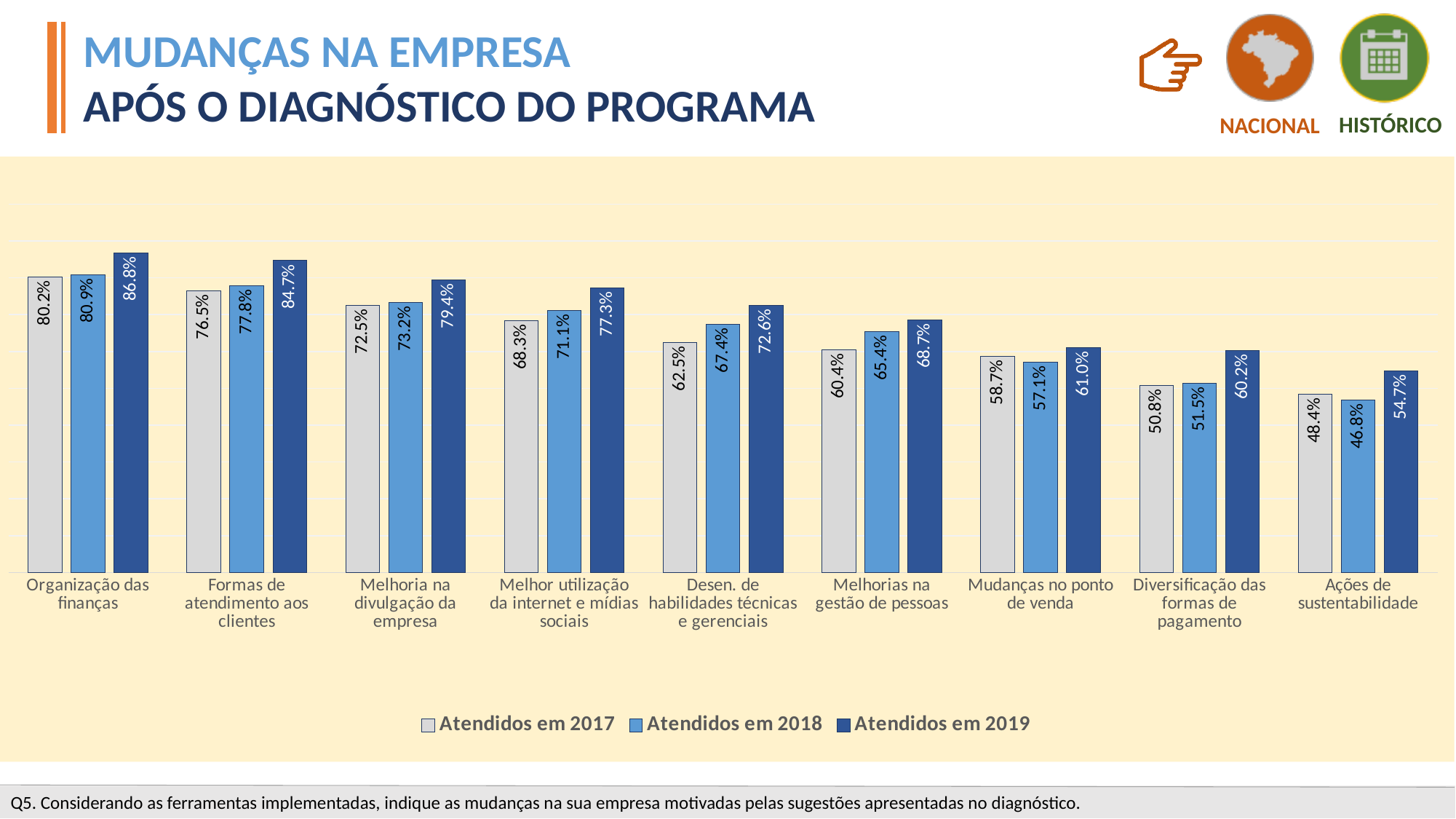
Which category has the highest value for "Atendidos em 2019"? Organização das finanças Which series is shown in the darkest blue colour in the legend? Atendidos em 2019 What is the difference between the "Atendidos em 2019" and "Atendidos em 2017" values for "Diversificação das formas de pagamento"? 9.4% Which category has the lowest value for "Atendidos em 2018"? Ações de sustentabilidade What is the value for "Atendidos em 2019" in the "Organização das finanças" category? 86.8% What is the value for "Atendidos em 2017" in the "Ações de sustentabilidade" category? 48.4% Which is larger for "Mudanças no ponto de venda": the "Atendidos em 2017" value or the "Atendidos em 2018" value? Atendidos em 2017 What kind of chart is shown on the slide? Bar chart How many series does the legend list? 3 How many categories are shown on the x axis of the chart? 9 Do the "Atendidos em 2019" values generally rise or fall from left to right across the categories? Fall What is the value for "Atendidos em 2018" in the "Desen. de habilidades técnicas e gerenciais" category? 67.4%